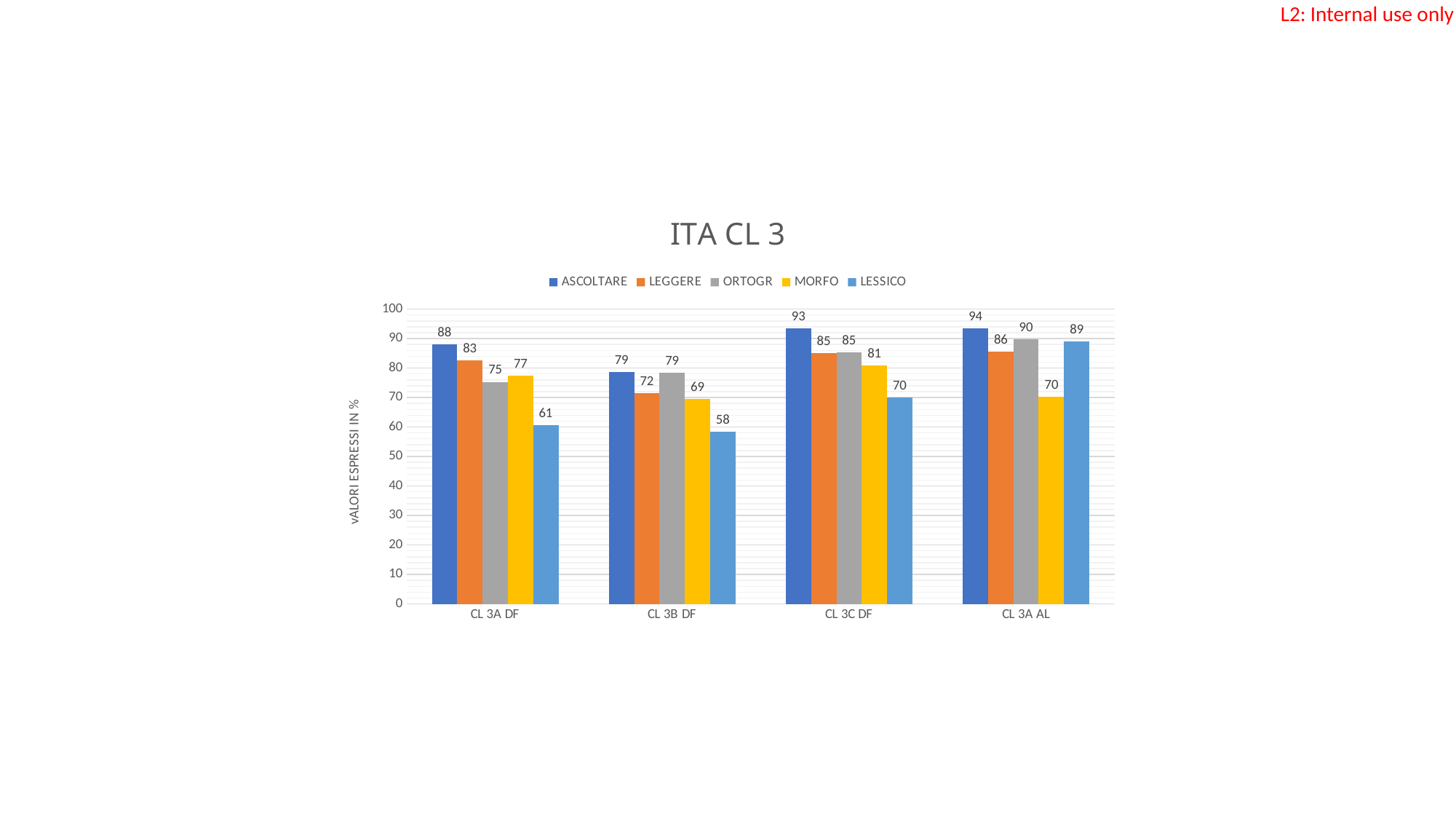
What is the ORTOGR value for CL 3A AL? 90 What is the MORFO value for CL 3C DF? 81 What is the difference between the LESSICO values for CL 3A AL and CL 3B DF? 31 What is the ASCOLTARE value for CL 3A DF? 88 What is the LESSICO value for CL 3B DF? 58 Which category has the highest ASCOLTARE value? CL 3A AL How many series does the legend list? 5 Which is larger, the MORFO value for CL 3A DF or the MORFO value for CL 3B DF? CL 3A DF How many categories are shown on the x axis? 4 Which category has the lowest LESSICO value? CL 3B DF What kind of chart is shown? bar chart What is the title of the chart? ITA CL 3